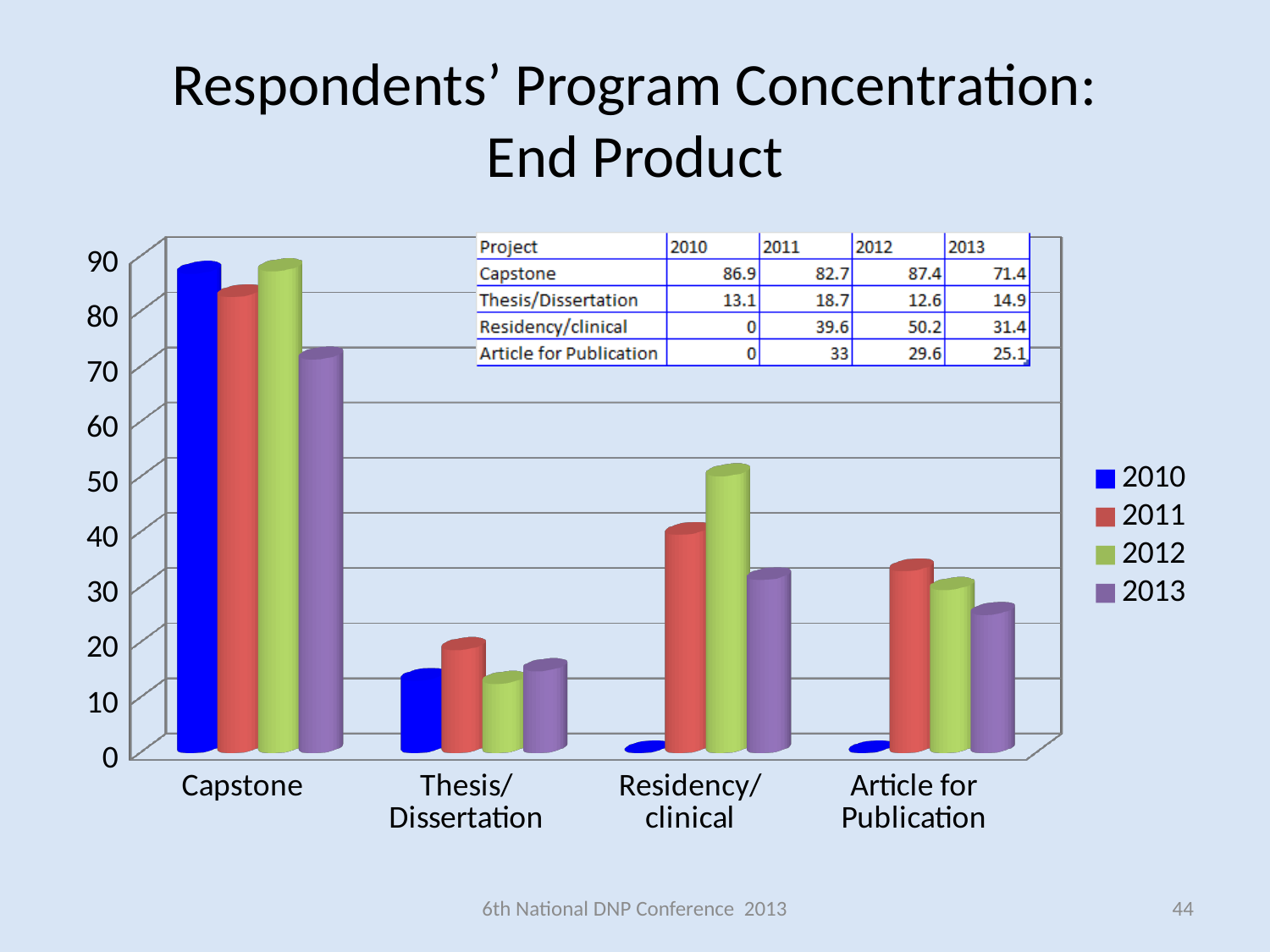
Which is larger for Thesis/Dissertation: the 2011 value or the 2013 value? 2011 Which year has the lowest value for Capstone? 2013 Which category has the highest value in 2013? Capstone What is the value for Residency/clinical in 2011? 39.6 What is the value for Capstone in 2012? 87.4 What is the difference between the 2012 and 2013 values for Residency/clinical? 18.8 How many categories are shown on the x axis? 4 What is the value for Article for Publication in 2010? 0 How many series does the legend list? 4 Is the value for Article for Publication in 2011 greater or less than 30? greater Which colour represents the 2012 series in the legend? green What kind of chart is shown on the slide? bar chart